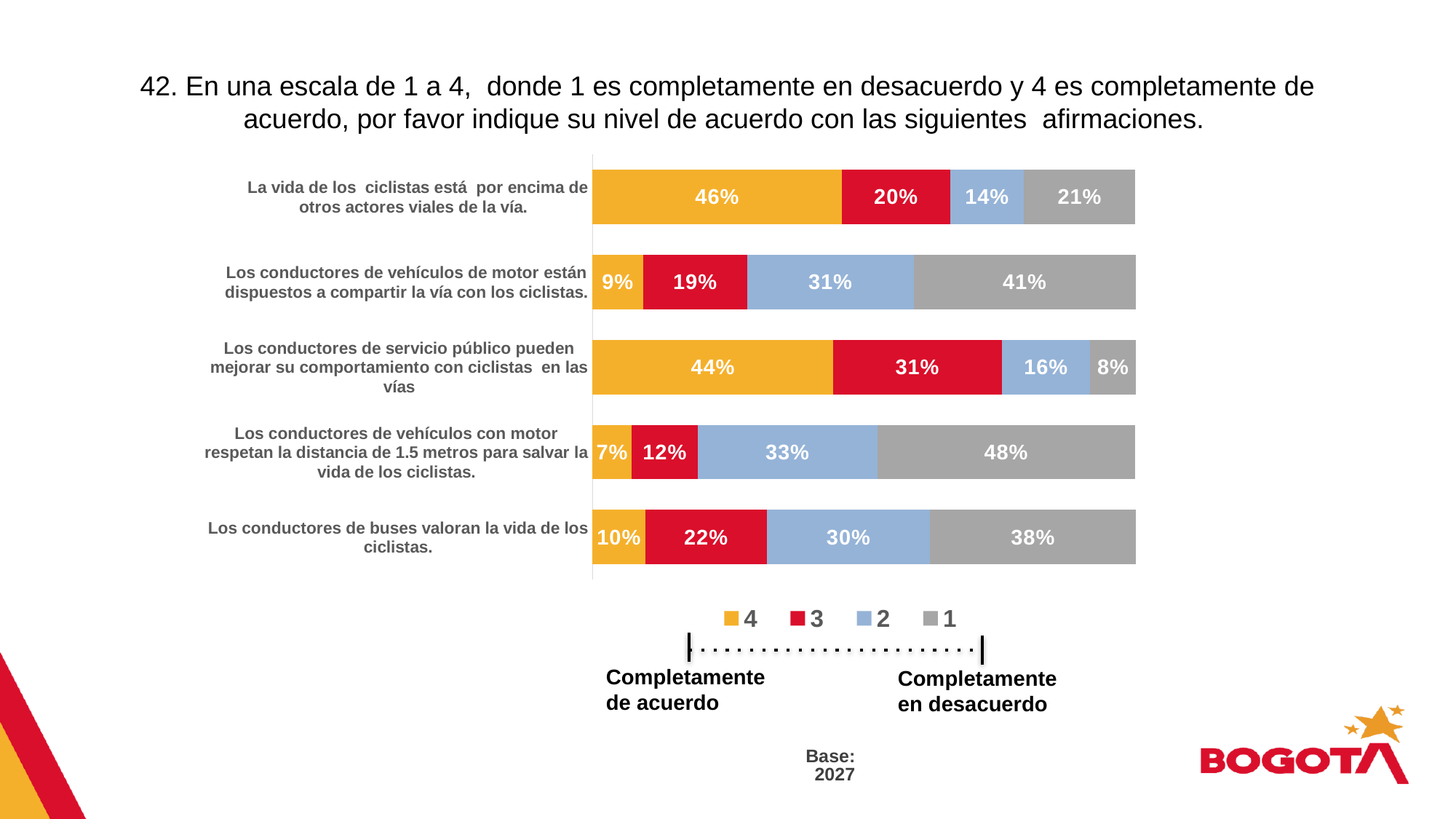
What is the total of the printed values for the bar "Los conductores de vehículos de motor están dispuestos a compartir la vía con los ciclistas"? 100% What kind of chart is shown on the slide? Stacked bar chart Which statement has the lowest share of respondents giving a rating of 1? Los conductores de servicio público pueden mejorar su comportamiento con ciclistas en las vías How many series does the legend list? 4 What percentage gave a rating of 1 for the statement "Los conductores de vehículos con motor respetan la distancia de 1.5 metros para salvar la vida de los ciclistas"? 48% What are the entries listed in the chart legend? 4, 3, 2, 1 For the statement "Los conductores de vehículos de motor están dispuestos a compartir la vía con los ciclistas", what is the difference between the share rating 1 and the share rating 4? 32 percentage points What percentage gave a rating of 2 for the statement "Los conductores de buses valoran la vida de los ciclistas"? 30% How many statements are shown in the chart? 5 Which statement has the highest share of respondents giving a rating of 4? La vida de los ciclistas está por encima de otros actores viales de la vía Which statement has a larger share of rating 3: "Los conductores de servicio público pueden mejorar su comportamiento con ciclistas en las vías" or "Los conductores de buses valoran la vida de los ciclistas"? Los conductores de servicio público pueden mejorar su comportamiento con ciclistas en las vías What percentage of respondents gave a rating of 4 for the statement "La vida de los ciclistas está por encima de otros actores viales de la vía"? 46%